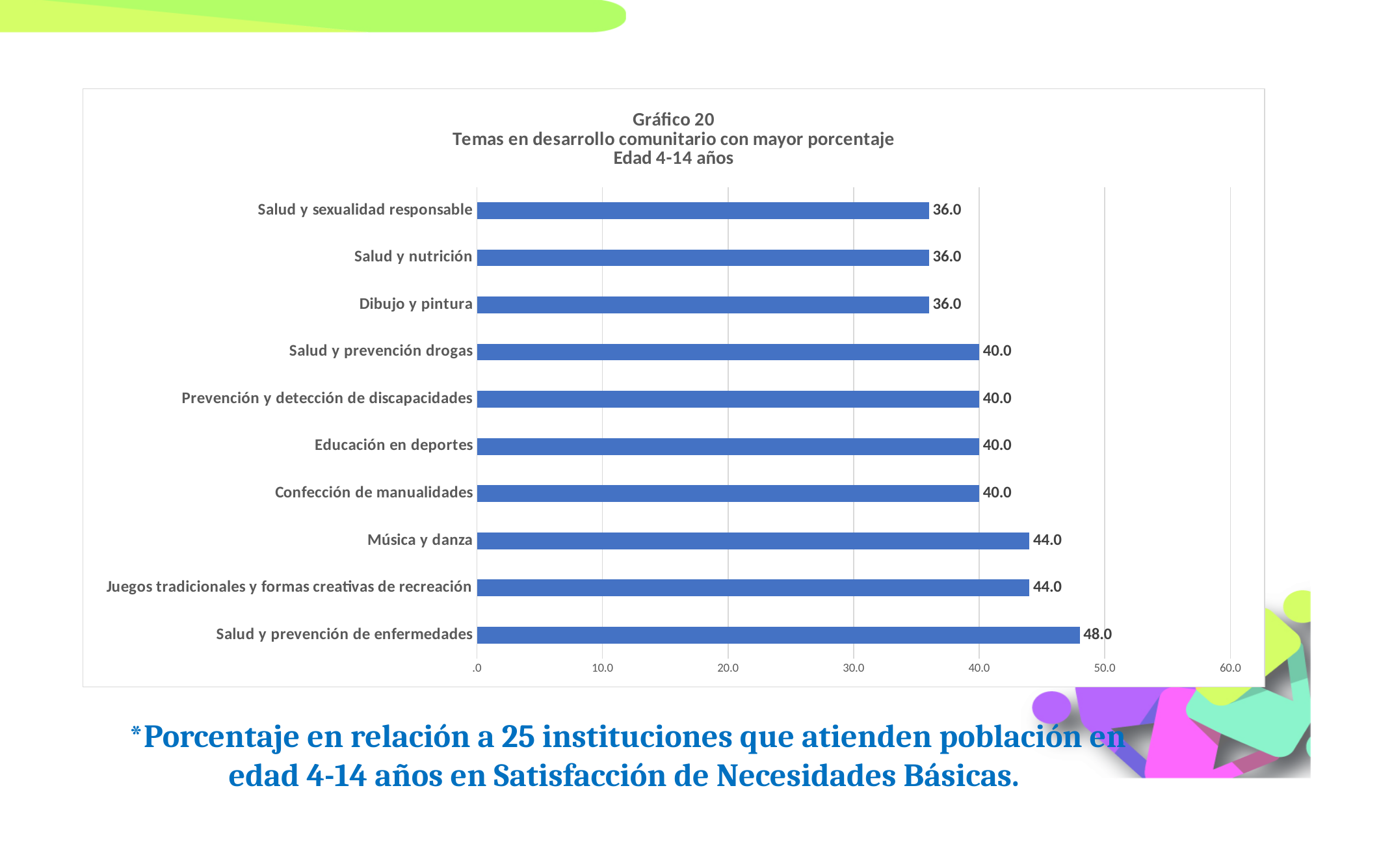
What is the difference between Salud y prevención de enfermedades and Salud y nutrición? 12.0 Which is larger, Salud y prevención drogas or Salud y sexualidad responsable? Salud y prevención drogas What is the value for Música y danza? 44.0 How many categories are shown in the chart? 10 What kind of chart is shown on the slide? Bar chart What is the title of the chart? Gráfico 20 Temas en desarrollo comunitario con mayor porcentaje Edad 4-14 años Which category has the highest value? Salud y prevención de enfermedades What is the difference between Juegos tradicionales y formas creativas de recreación and Confección de manualidades? 4.0 What is the value for Educación en deportes? 40.0 Is the value for Música y danza greater or less than 40.0? greater What is the value for Dibujo y pintura? 36.0 What is the value for Salud y prevención de enfermedades? 48.0